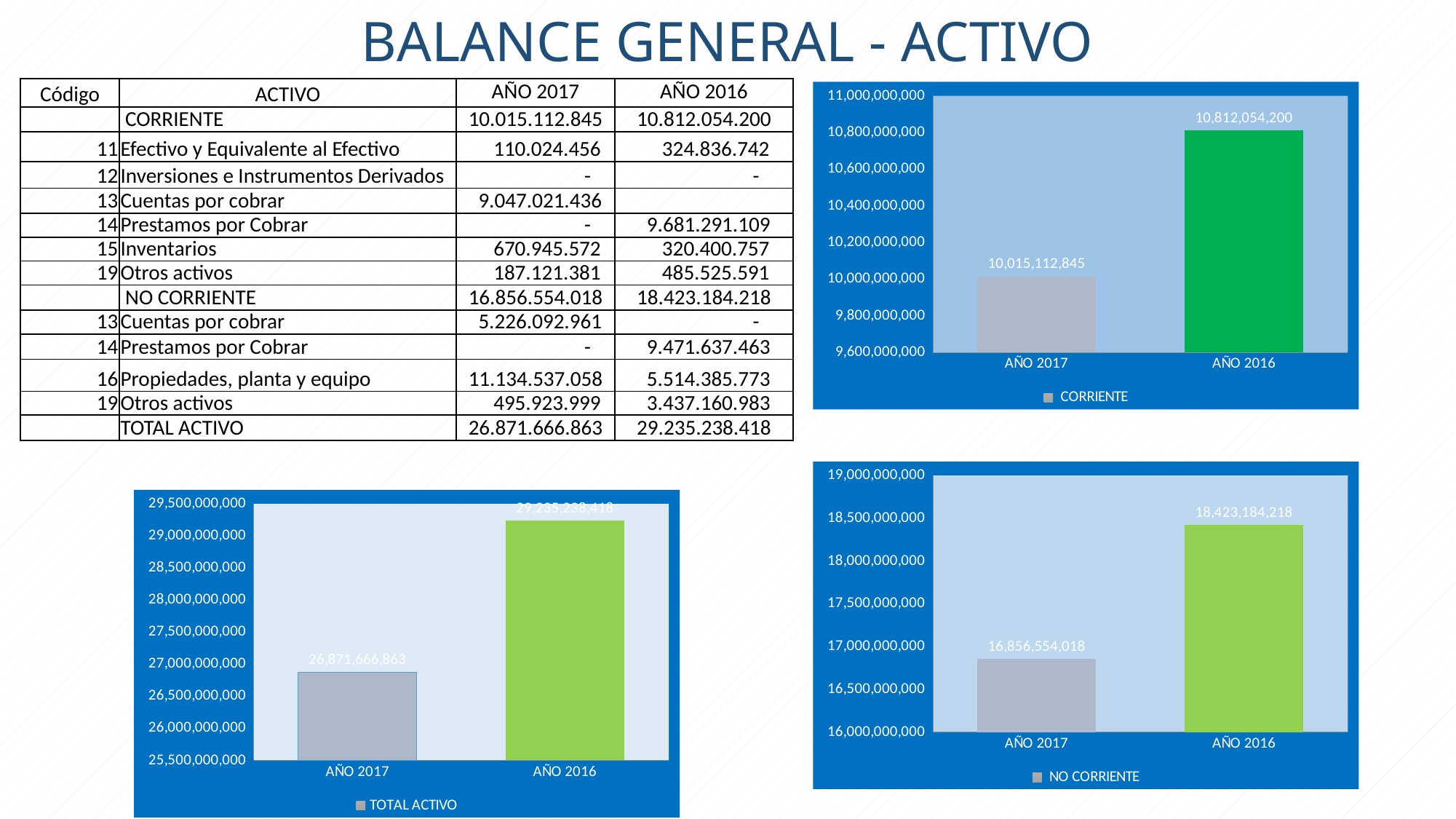
In the NO CORRIENTE chart, what is the difference between the AÑO 2016 and AÑO 2017 values? 1,566,630,200 In the TOTAL ACTIVO chart, what is the value for AÑO 2017? 26,871,666,863 In the TOTAL ACTIVO chart, which year has the highest value? AÑO 2016 In the CORRIENTE chart, what is the difference between the AÑO 2016 and AÑO 2017 values? 796,941,355 In the CORRIENTE chart, is the value for AÑO 2017 larger or smaller than the value for AÑO 2016? smaller In the CORRIENTE chart, what is the value for AÑO 2017? 10,015,112,845 How many series does the legend of the TOTAL ACTIVO chart list? 1 In the CORRIENTE chart, what is the value for AÑO 2016? 10,812,054,200 In the NO CORRIENTE chart, what is the value for AÑO 2016? 18,423,184,218 In the TOTAL ACTIVO chart, is the value for AÑO 2016 greater or less than 29,000,000,000? greater What kind of chart is the NO CORRIENTE chart? bar chart In the NO CORRIENTE chart, which year has the lowest value? AÑO 2017